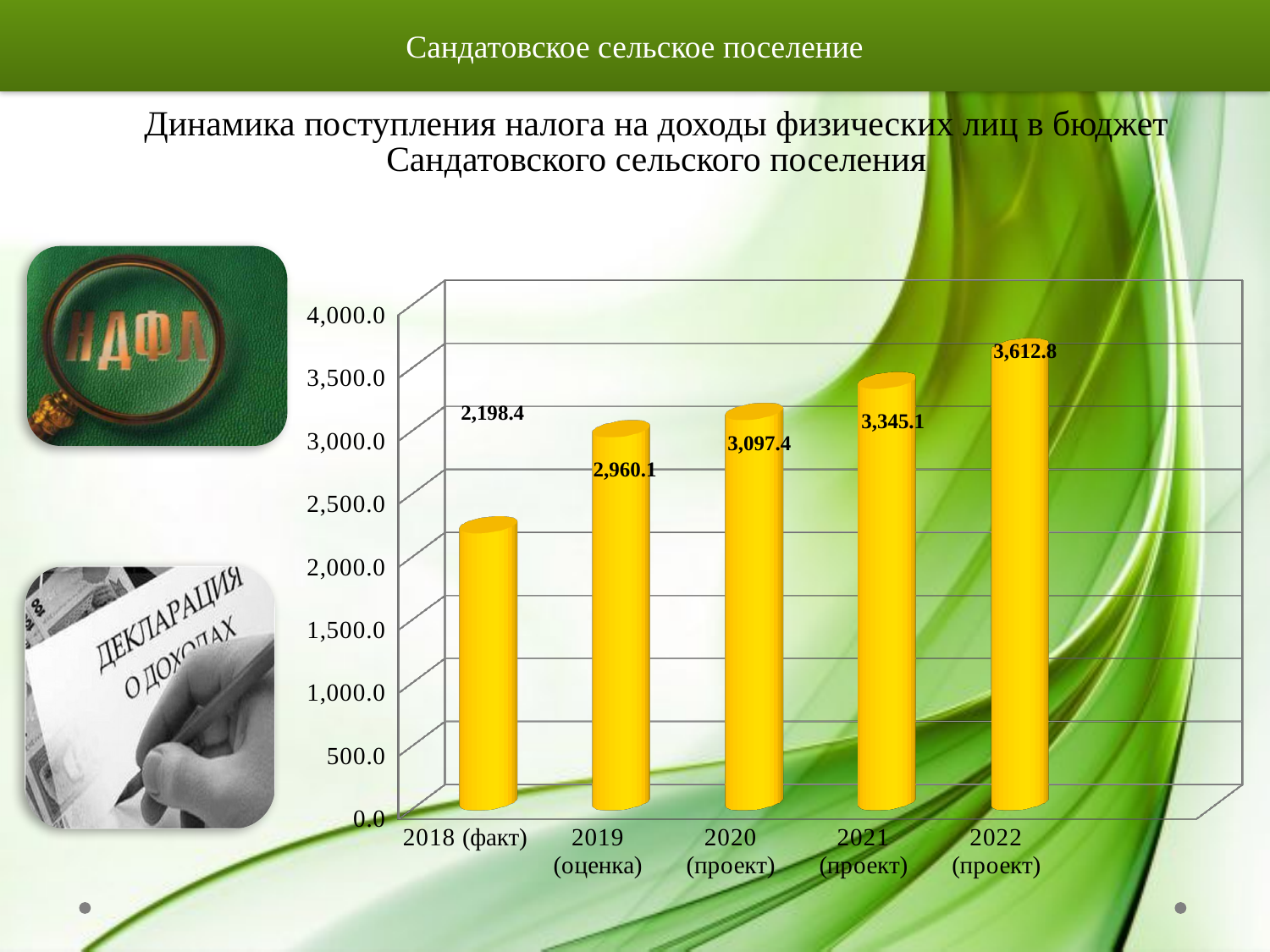
Is the value for 2018 (факт) greater or less than 2,500.0? less What is the value for 2020 (проект)? 3,097.4 What is the value for 2022 (проект)? 3,612.8 Do the values rise or fall from 2018 to 2022? rise What kind of chart is shown on the slide? bar chart What is the difference between the values for 2021 (проект) and 2020 (проект)? 247.7 What is the value for 2018 (факт)? 2,198.4 What is the difference between the values for 2022 (проект) and 2018 (факт)? 1,414.4 Which year has the lowest value? 2018 (факт) Which year has the highest value? 2022 (проект) How many years are shown on the x axis? 5 Which is larger, the value for 2019 (оценка) or the value for 2021 (проект)? 2021 (проект)